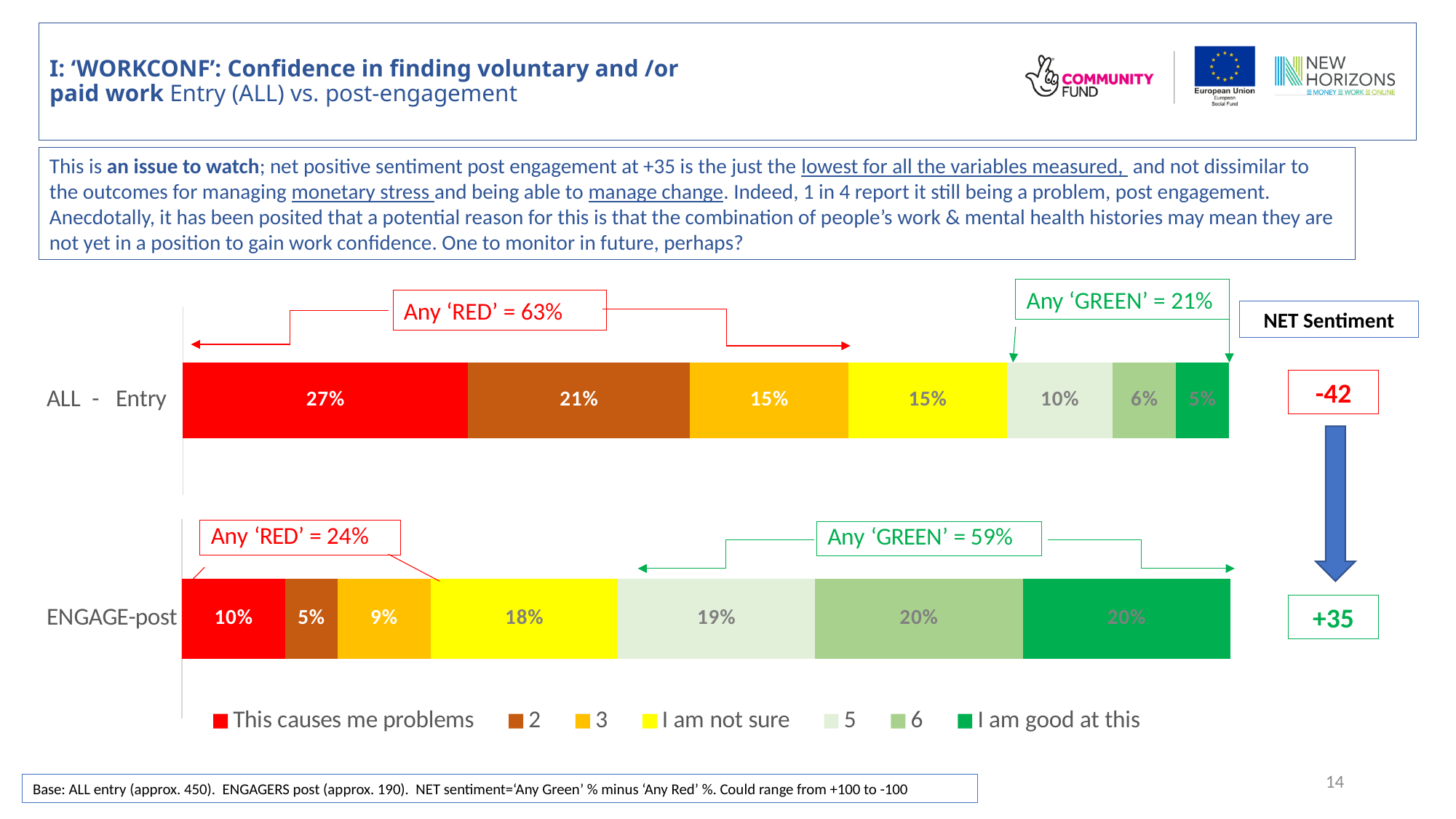
How many bars (categories) are plotted in the chart? 2 What is the value of 'I am good at this' for ENGAGE-post? 20% Which segment is the smallest in the ENGAGE-post bar? 2 How many series does the legend list? 7 Which is larger: the 'I am good at this' value for ALL - Entry or for ENGAGE-post? ENGAGE-post What is the difference between the 'This causes me problems' values for ALL - Entry and ENGAGE-post? 17% What is the value of 'I am not sure' for ALL - Entry? 15% Which segment is the largest in the ALL - Entry bar? This causes me problems What kind of chart is shown on the slide? Stacked bar chart What is the value of 'This causes me problems' for ALL - Entry? 27% What is the value of series '2' for ENGAGE-post? 5% What NET Sentiment value is shown for ENGAGE-post? +35